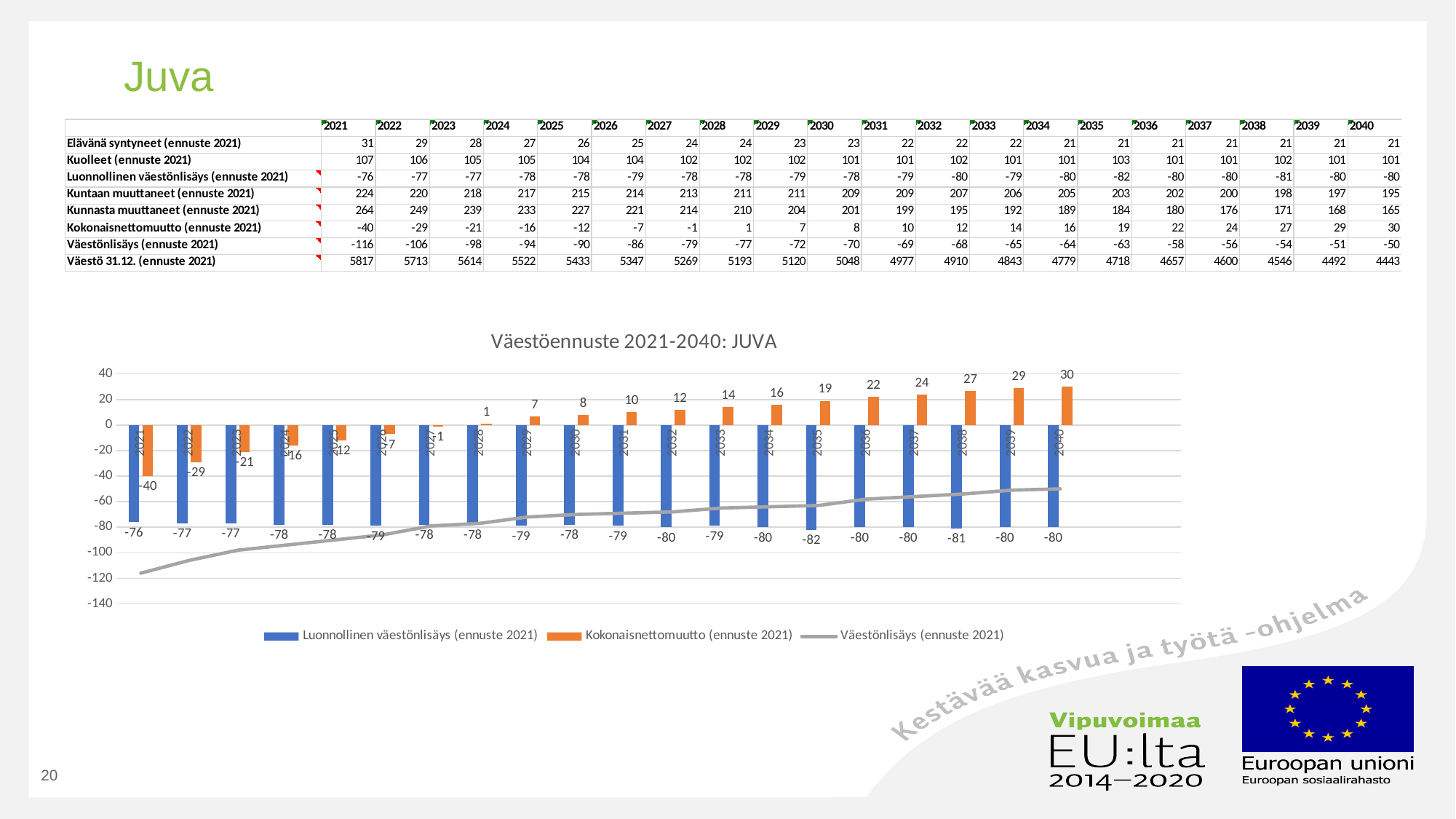
How many series does the legend of the chart list? 3 In which year is Kokonaisnettomuutto (ennuste 2021) highest in the chart? 2040 What type of chart is shown under the title 'Väestöennuste 2021-2040: JUVA'? Bar chart with a line How many years are shown on the x axis of the chart? 20 What is the value of Kokonaisnettomuutto (ennuste 2021) for 2040 in the chart? 30 What is the value of Kokonaisnettomuutto (ennuste 2021) for 2021 in the chart? -40 What is the value of Luonnollinen väestönlisäys (ennuste 2021) for 2035 in the chart? -82 What is the difference between the Kokonaisnettomuutto values for 2040 and 2021 in the chart? 70 Which is larger in the chart: Kokonaisnettomuutto for 2030 or for 2036? 2036 Does Kokonaisnettomuutto (ennuste 2021) rise or fall from 2021 to 2040 in the chart? Rise Is the Väestönlisäys (ennuste 2021) line value for 2021 greater or less than -100? less In which year is Kokonaisnettomuutto (ennuste 2021) lowest in the chart? 2021